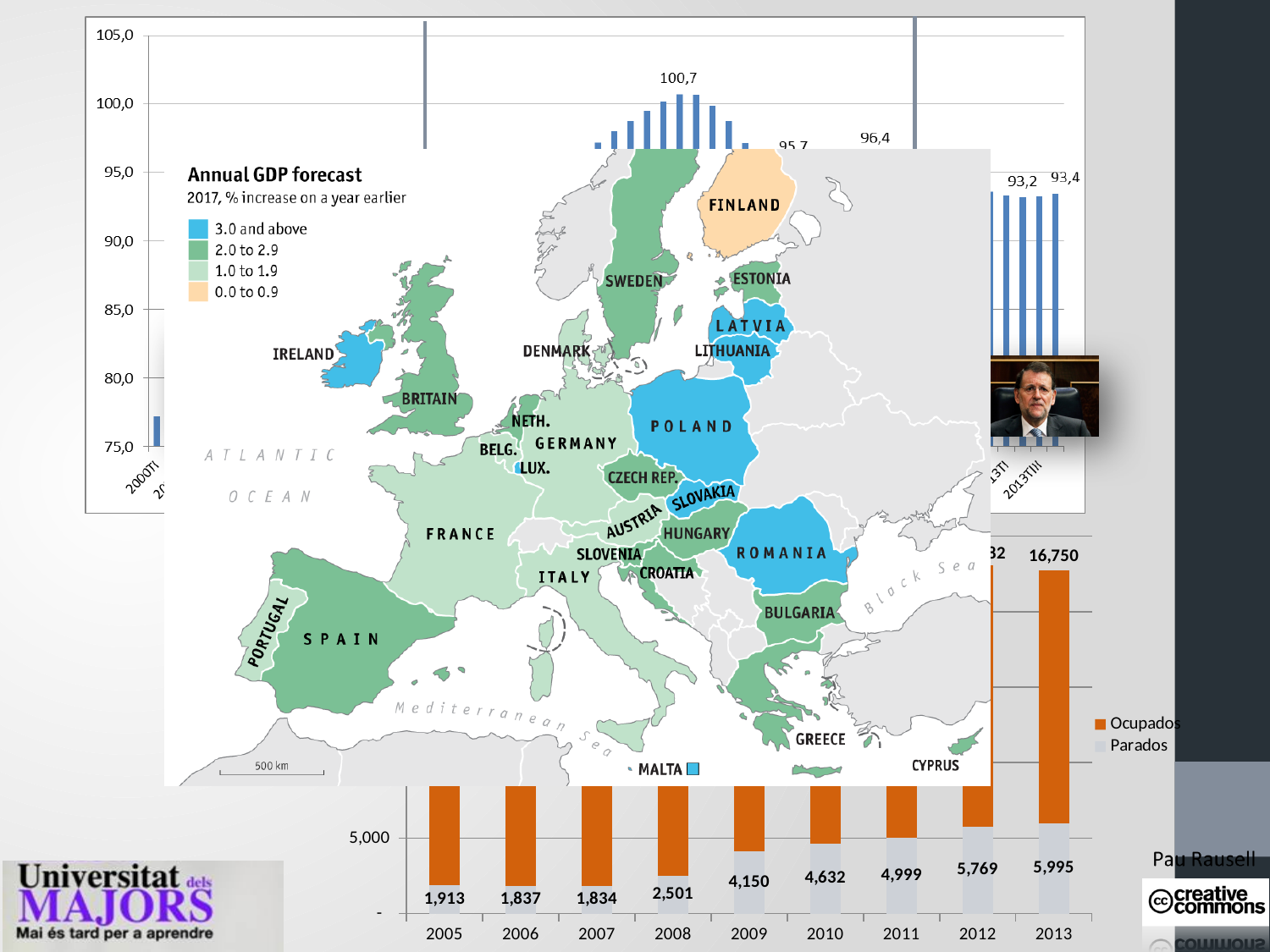
How many years are shown on the x axis of the bottom stacked bar chart? 9 In the bottom stacked bar chart, which year has the larger Parados value, 2010 or 2011? 2011 In the bottom stacked bar chart, what is the Parados value for 2013? 5,995 In the bottom stacked bar chart, which year has the lowest Parados value? 2007 Do the Parados values in the bottom chart rise or fall from 2008 to 2013? rise In the bottom stacked bar chart, which year has the highest Parados value? 2013 In the bottom stacked bar chart, what is the difference between the Parados values for 2013 and 2005? 4,082 In the bottom stacked bar chart, what is the Parados value for 2009? 4,150 How many series does the legend of the bottom stacked bar chart list? 2 In the bottom stacked bar chart, what is the difference between the Parados values for 2012 and 2011? 770 In the bottom stacked bar chart, what is the Ocupados value for 2013? 16,750 In the top bar chart, what is the highest value labelled on the bars? 100,7